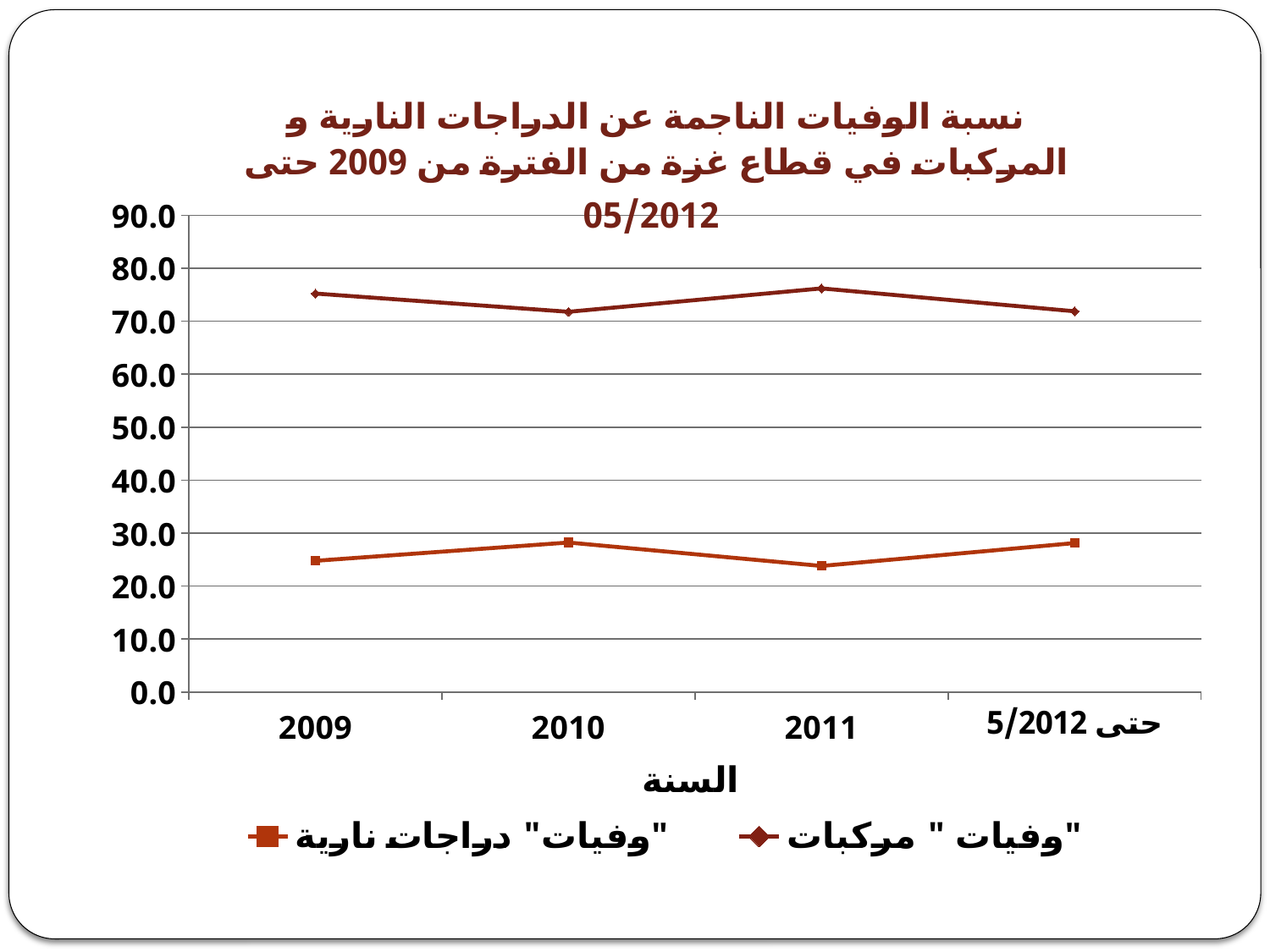
Does the "وفيات" دراجات نارية" line rise or fall from 2011 to حتى 5/2012? rise Is the value for "وفيات " مركبات" in 2009 greater or less than 70? greater Is the value for "وفيات" دراجات نارية" in 2011 greater or less than 30? less How many time points are plotted along the x axis? 4 What is the title of the x axis? السنة Which series has the higher value in 2010, "وفيات " مركبات" or "وفيات" دراجات نارية"? وفيات " مركبات What is the label of the last category on the x axis? حتى 5/2012 What kind of chart is shown on the slide? Line chart Is the value for "وفيات" دراجات نارية" in 2010 greater or less than 20? greater Does the "وفيات " مركبات" line rise or fall from 2009 to 2010? fall How many series does the legend list? 2